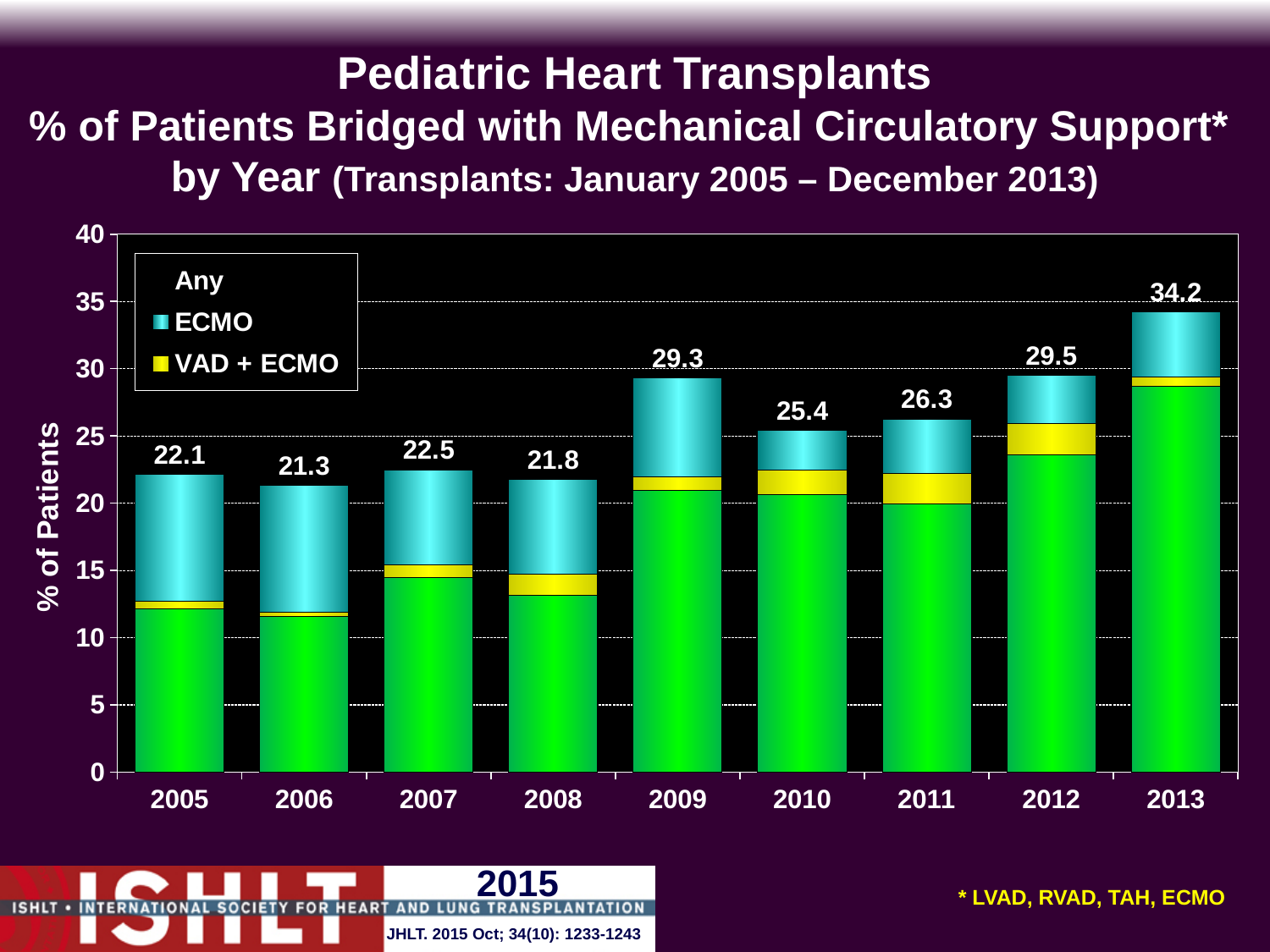
What is the total value shown for 2006? 21.3 How many entries does the legend list? 3 What is the total percentage of patients bridged with mechanical circulatory support in 2013? 34.2 Is the green (bottom) segment of the 2013 bar greater or less than 25? greater What is the label on the y axis? % of Patients Which year has the highest total percentage of patients bridged with mechanical circulatory support? 2013 Which year has the lowest total percentage of patients bridged with mechanical circulatory support? 2006 What is the total value shown for 2009? 29.3 Which year has a larger total value, 2010 or 2011? 2011 What is the difference between the total values for 2013 and 2005? 12.1 What kind of chart is shown on the slide? Stacked bar chart How many years are shown on the x axis? 9